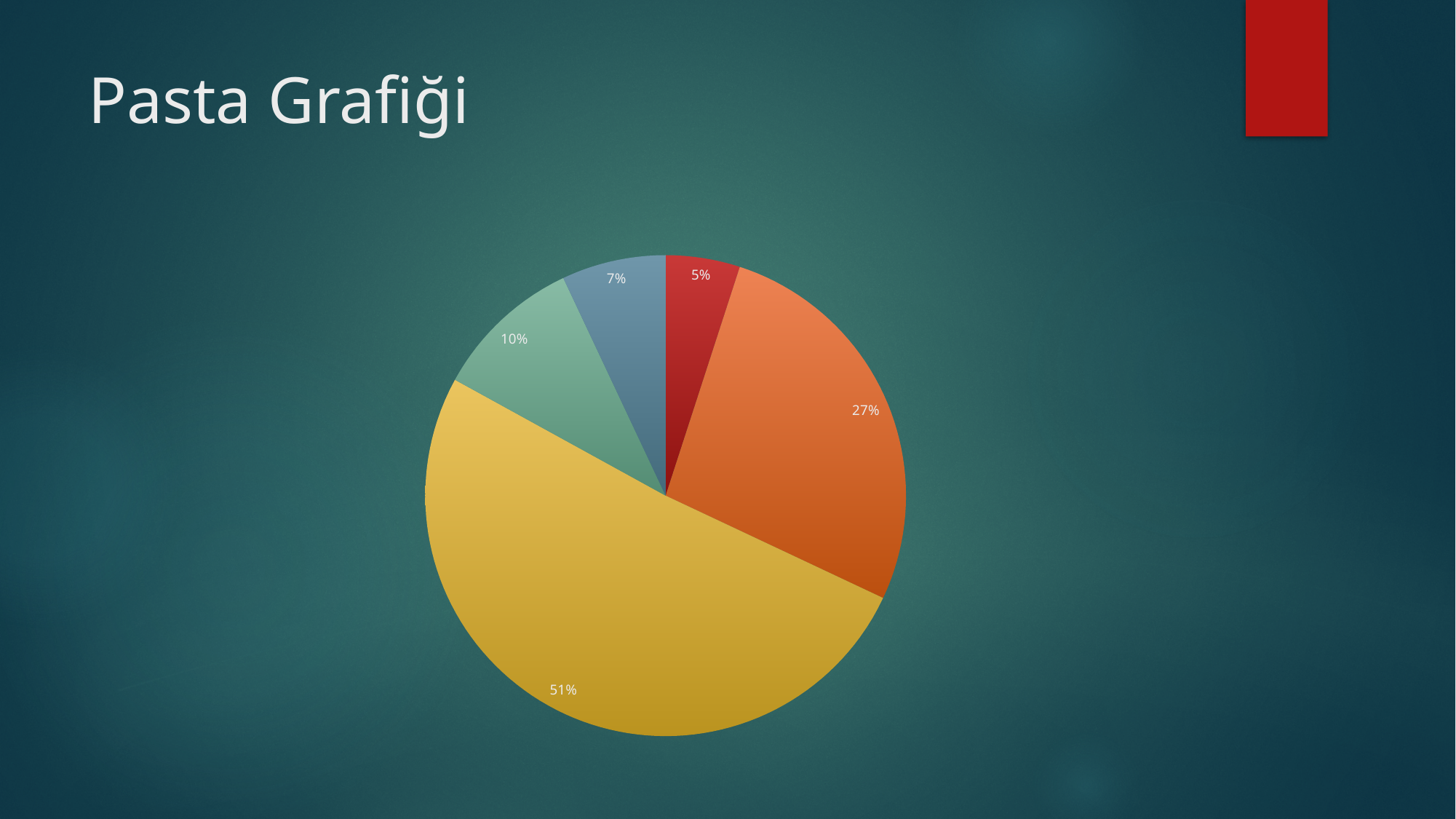
How many slices does the pie chart have? 5 What percentage is shown on the largest slice of the pie chart? 51% Which slice is larger in the pie chart, the green slice or the blue slice? the green slice What percentage is shown on the green slice of the pie chart? 10% What percentage is shown on the blue slice of the pie chart? 7% What kind of chart is shown on the slide? pie chart What percentage is shown on the yellow slice of the pie chart? 51% What is the difference between the yellow slice's percentage and the orange slice's percentage in the pie chart? 24% What percentage is shown on the smallest slice of the pie chart? 5% What percentage is shown on the red slice of the pie chart? 5% What is the title of the slide containing the pie chart? Pasta Grafiği What percentage is shown on the orange slice of the pie chart? 27%